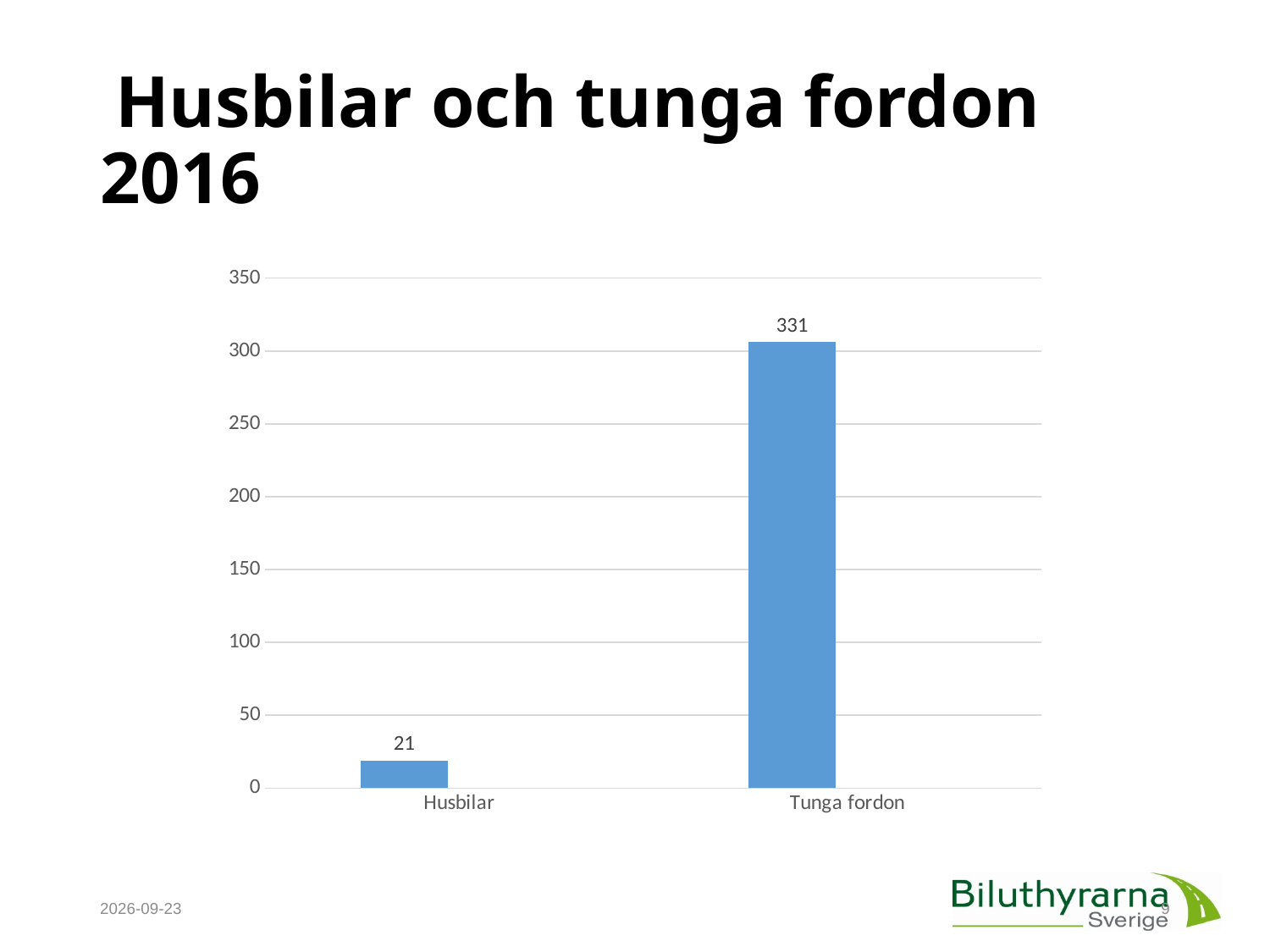
What is the highest value shown on the y axis? 350 Which is larger, the value for Husbilar or the value for Tunga fordon? Tunga fordon How many categories are shown on the x axis? 2 Is the value for Husbilar greater or less than 50? less Is the value for Tunga fordon greater or less than 300? greater What kind of chart is shown on the slide? bar chart What is the difference between the values for Tunga fordon and Husbilar? 310 What is the title of the slide? Husbilar och tunga fordon 2016 Which category has the highest value? Tunga fordon What is the value for Husbilar? 21 What is the value for Tunga fordon? 331 Which category has the lowest value? Husbilar